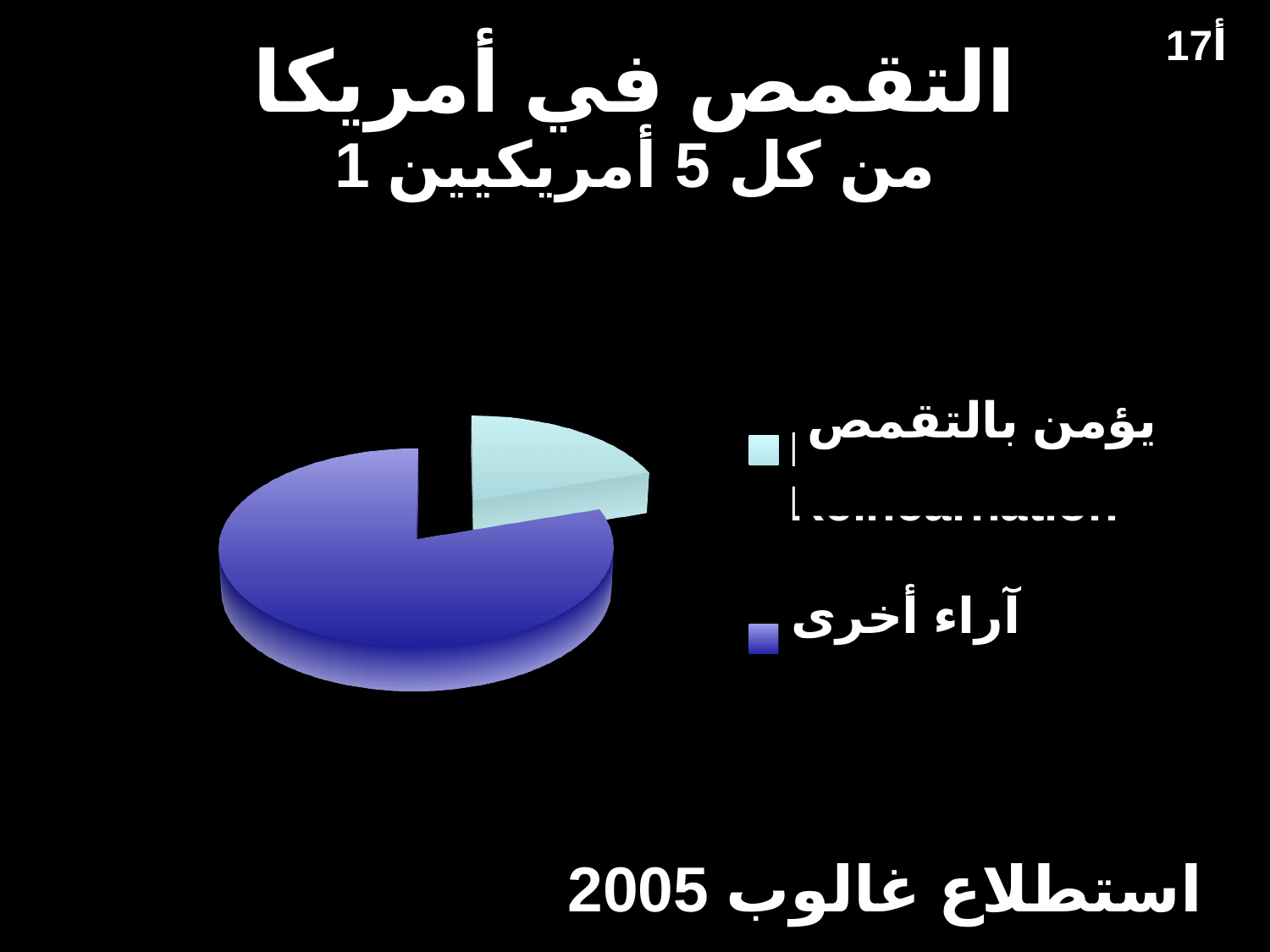
Which category has the smallest slice in the pie chart? يؤمن بالتقمص How many slices does the pie chart have? 2 What is the title of the slide containing the pie chart? التقمص في أمريكا What kind of chart is shown on the slide? pie chart How many entries does the legend of the pie chart list? 2 Which slice is larger: يؤمن بالتقمص or آراء أخرى? آراء أخرى Which category has the largest slice in the pie chart? آراء أخرى What colour is the slice for يؤمن بالتقمص in the pie chart? light cyan